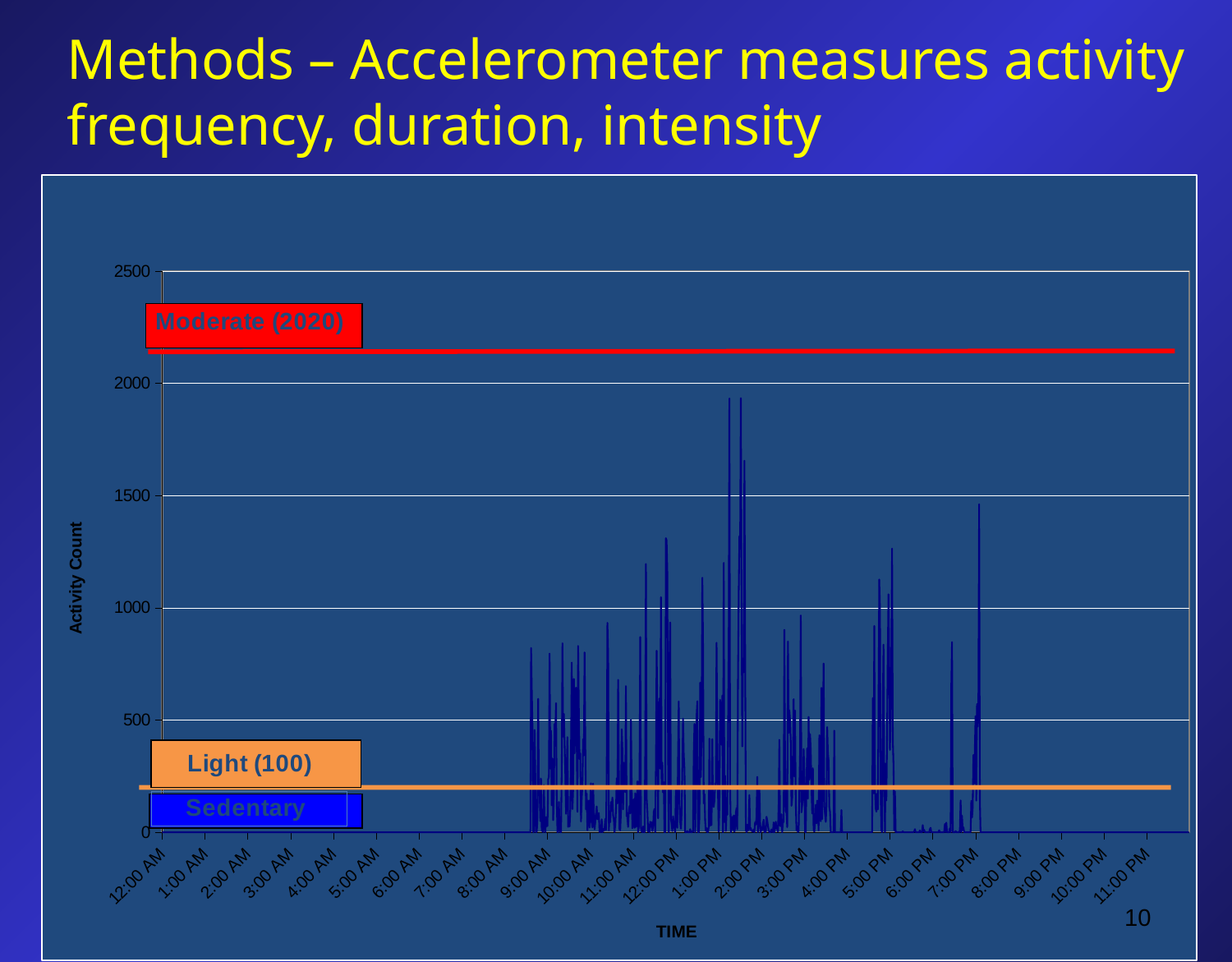
How many time labels are shown along the x axis? 24 Is the activity count at 9:00 PM greater or less than 500? less Is the activity count higher around 1:00 PM or around 2:00 AM? 1:00 PM Is the highest activity spike on the chart greater or less than 1500? greater What kind of chart is shown on the slide? line chart What is the label of the x axis? TIME What activity count threshold is given for the Light level? 100 What is the label of the y axis? Activity Count Is the activity count at 3:00 AM greater or less than 500? less What activity count threshold is given for the Moderate level? 2020 What is the highest value shown on the y axis? 2500 Does any activity spike reach the red Moderate threshold line? No